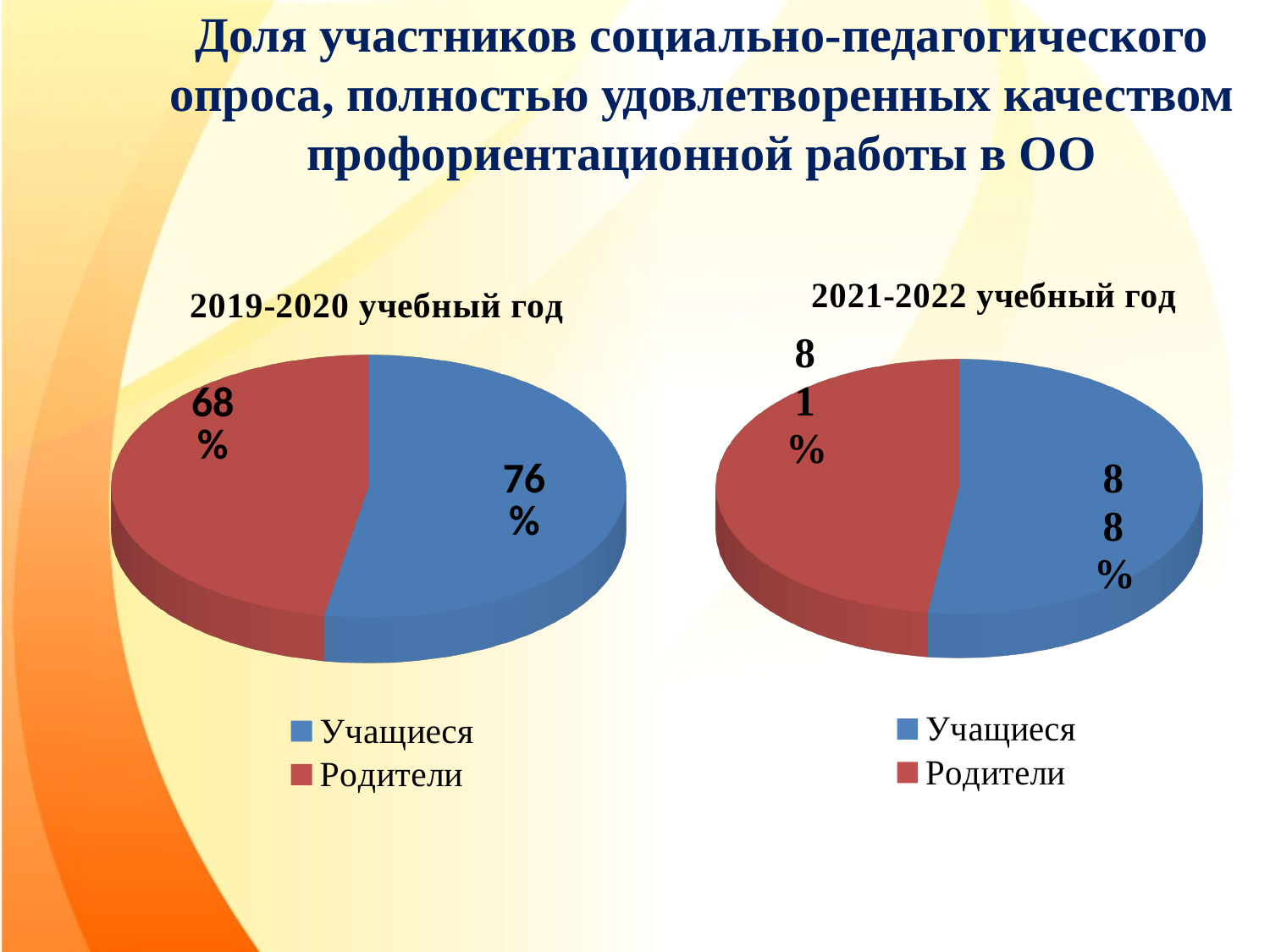
In the 2021-2022 учебный год chart, which colour represents Родители? Red How many slices does the 2021-2022 учебный год pie chart have? 2 In the 2019-2020 учебный год chart, which group has the larger value, Учащиеся or Родители? Учащиеся In the 2019-2020 учебный год chart, what value is shown for Учащиеся? 76% In the 2019-2020 учебный год chart, what value is shown for Родители? 68% In the 2021-2022 учебный год chart, what is the difference between the values for Учащиеся and Родители? 7% In the 2021-2022 учебный год chart, which group has the smaller value? Родители How many entries does the legend of the 2019-2020 учебный год chart list? 2 In the 2021-2022 учебный год chart, what value is shown for Учащиеся? 88% In the 2019-2020 учебный год chart, what is the difference between the values for Учащиеся and Родители? 8% What type of chart is used for the 2019-2020 учебный год data? Pie chart In the 2021-2022 учебный год chart, what value is shown for Родители? 81%